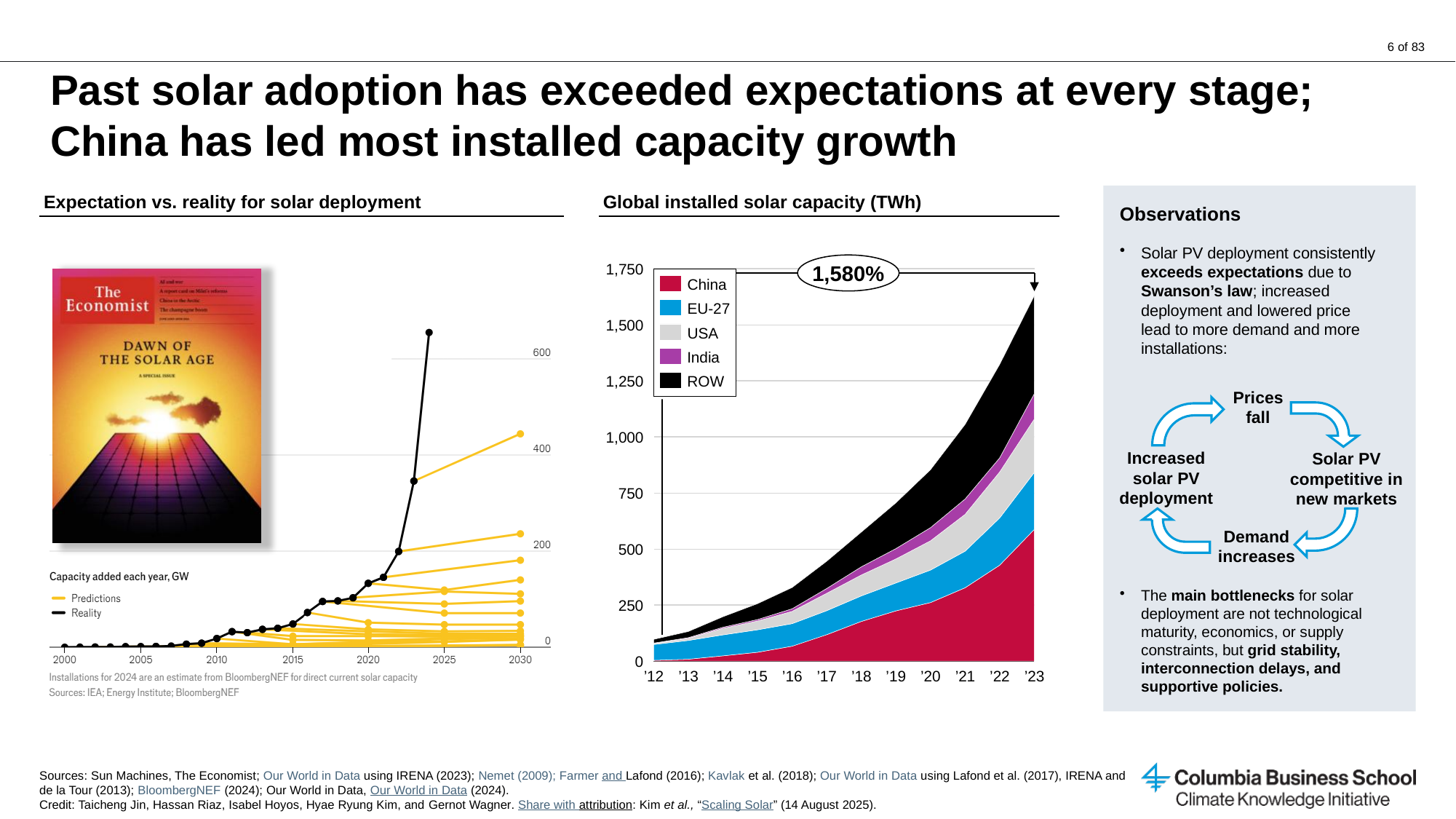
On the 'Global installed solar capacity (TWh)' chart, how many series does the legend list? 5 On the 'Global installed solar capacity (TWh)' chart, which series is the smallest in '23? India On the 'Global installed solar capacity (TWh)' chart, does total installed capacity rise or fall from '12 to '23? rise On the 'Global installed solar capacity (TWh)' chart, is the total installed capacity in '12 greater or less than 250? less On the 'Global installed solar capacity (TWh)' chart, which series is the largest in '23? China On the 'Expectation vs. reality for solar deployment' chart, what two series does the legend list? Predictions and Reality On the 'Global installed solar capacity (TWh)' chart, which is larger in '23, China or EU-27? China On the 'Global installed solar capacity (TWh)' chart, is the total installed capacity in '23 greater or less than 1,500? greater On the 'Global installed solar capacity (TWh)' chart, what percentage growth is shown in the annotation above the chart? 1,580% On the 'Expectation vs. reality for solar deployment' chart, is the Reality value for 2024 greater or less than 600? greater On the 'Expectation vs. reality for solar deployment' chart, what kind of chart is it? line chart On the 'Global installed solar capacity (TWh)' chart, how many years are shown on the x axis? 12